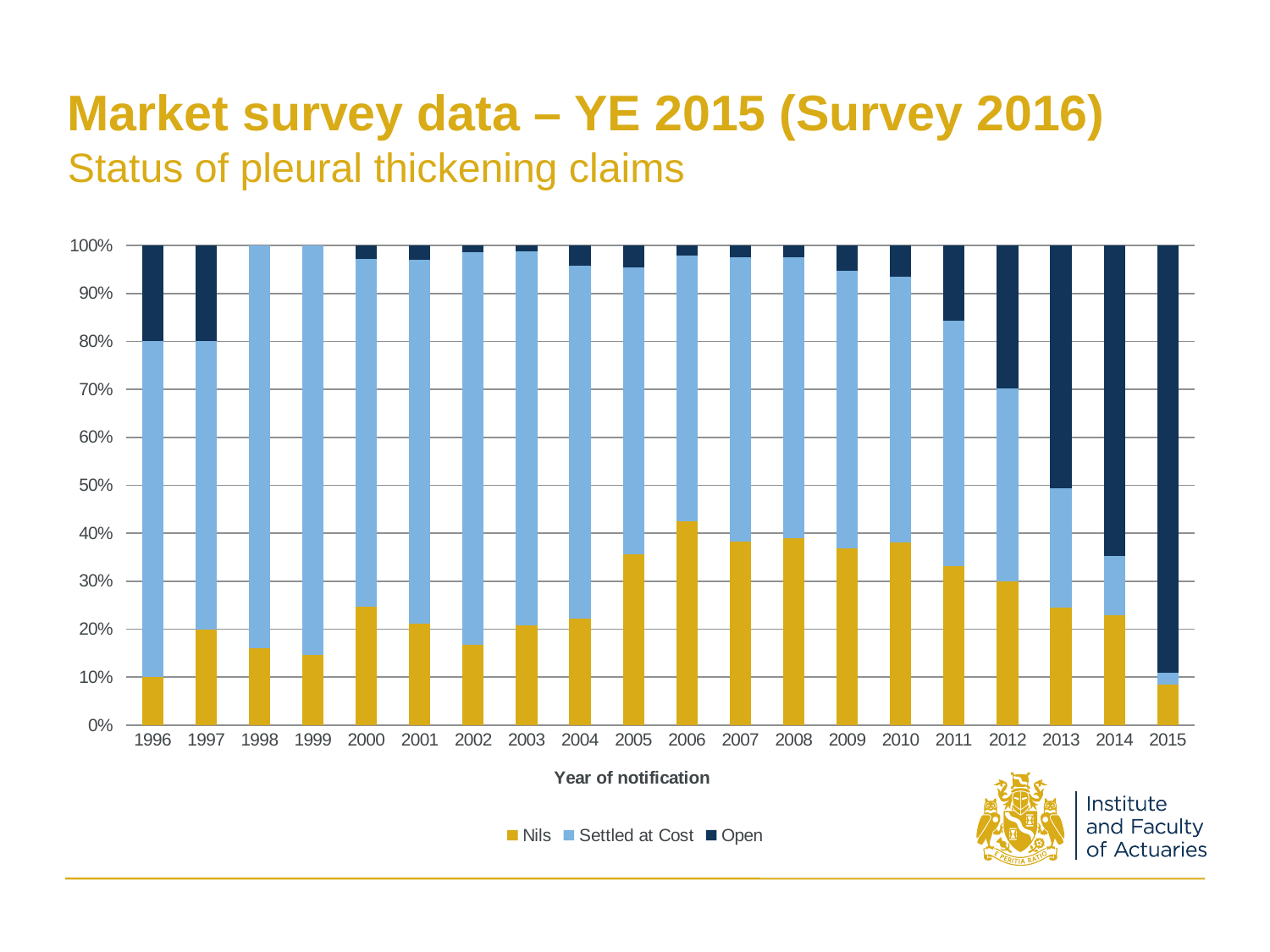
Is the Open share for 2015 greater or less than 80%? greater Is the Nils share for 2015 greater or less than 10%? less What is the title of the x axis? Year of notification How many years of notification are shown on the x axis? 20 Which series is shown in dark blue in the legend? Open What kind of chart is shown on the slide? Stacked bar chart In which year of notification is the Nils share the highest? 2006 Which year has the larger Nils share, 1996 or 1997? 1997 Does the Open share rise or fall from 2010 to 2015? Rise Is the Nils share for 2005 greater or less than 30%? greater How many series does the legend list? 3 In which year of notification is the Open share the highest? 2015